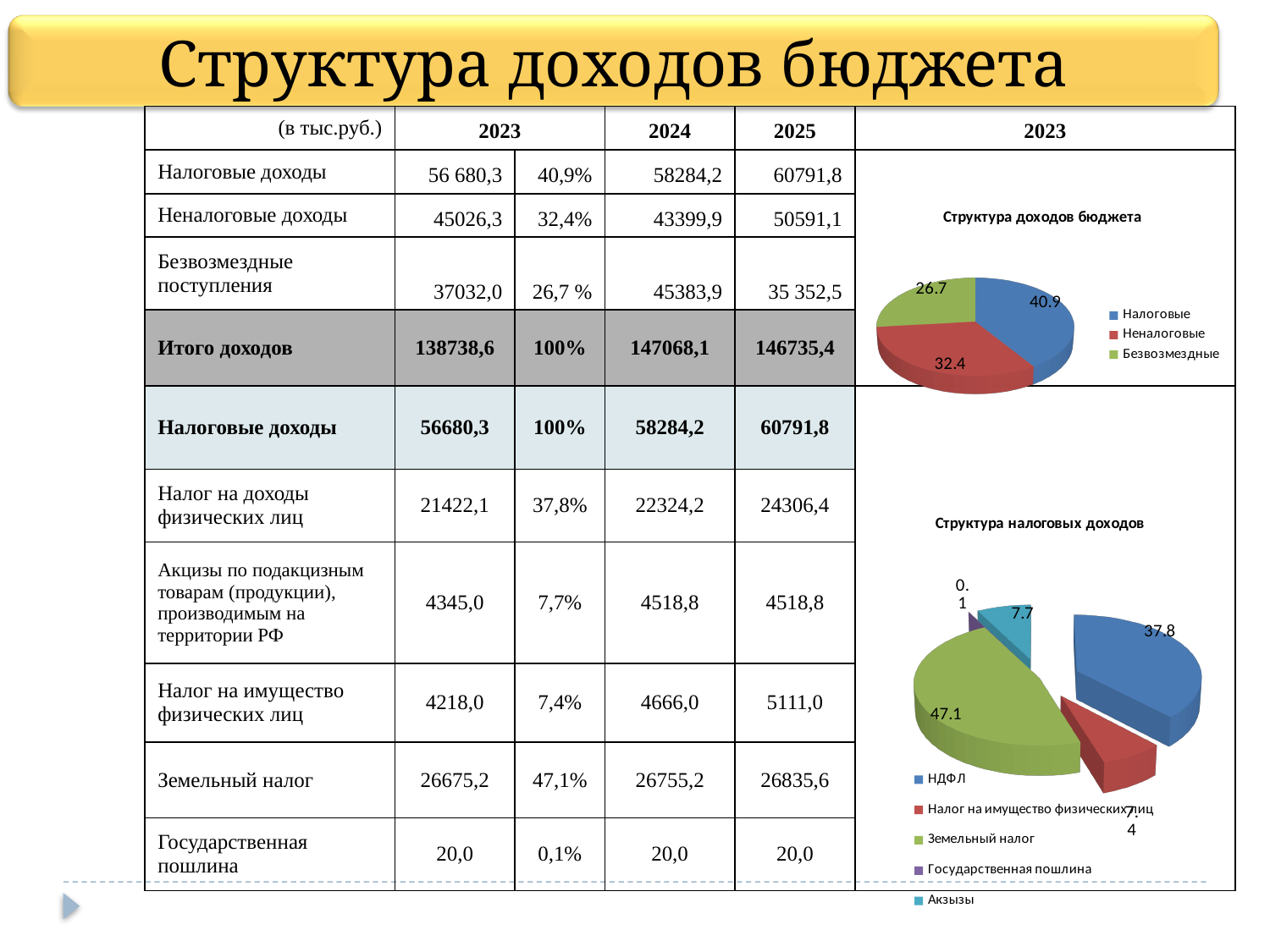
In the chart titled "Структура налоговых доходов", how many entries does the legend list? 5 In the chart titled "Структура доходов бюджета", what value is shown for the Неналоговые slice? 32.4 What kind of chart is the one titled "Структура налоговых доходов"? Pie chart In the chart titled "Структура налоговых доходов", what value is shown for the Земельный налог slice? 47.1 In the chart titled "Структура доходов бюджета", how many entries does the legend list? 3 In the chart titled "Структура налоговых доходов", which slice is the largest? Земельный налог In the chart titled "Структура доходов бюджета", which slice is the smallest? Безвозмездные In the chart titled "Структура налоговых доходов", what value is shown for the НДФЛ slice? 37.8 In the chart titled "Структура доходов бюджета", what is the difference between the Налоговые and Неналоговые values? 8.5 In the chart titled "Структура доходов бюджета", what value is shown for the Безвозмездные slice? 26.7 In the chart titled "Структура доходов бюджета", what value is shown for the Налоговые slice? 40.9 In the chart titled "Структура доходов бюджета", which slice is the largest? Налоговые